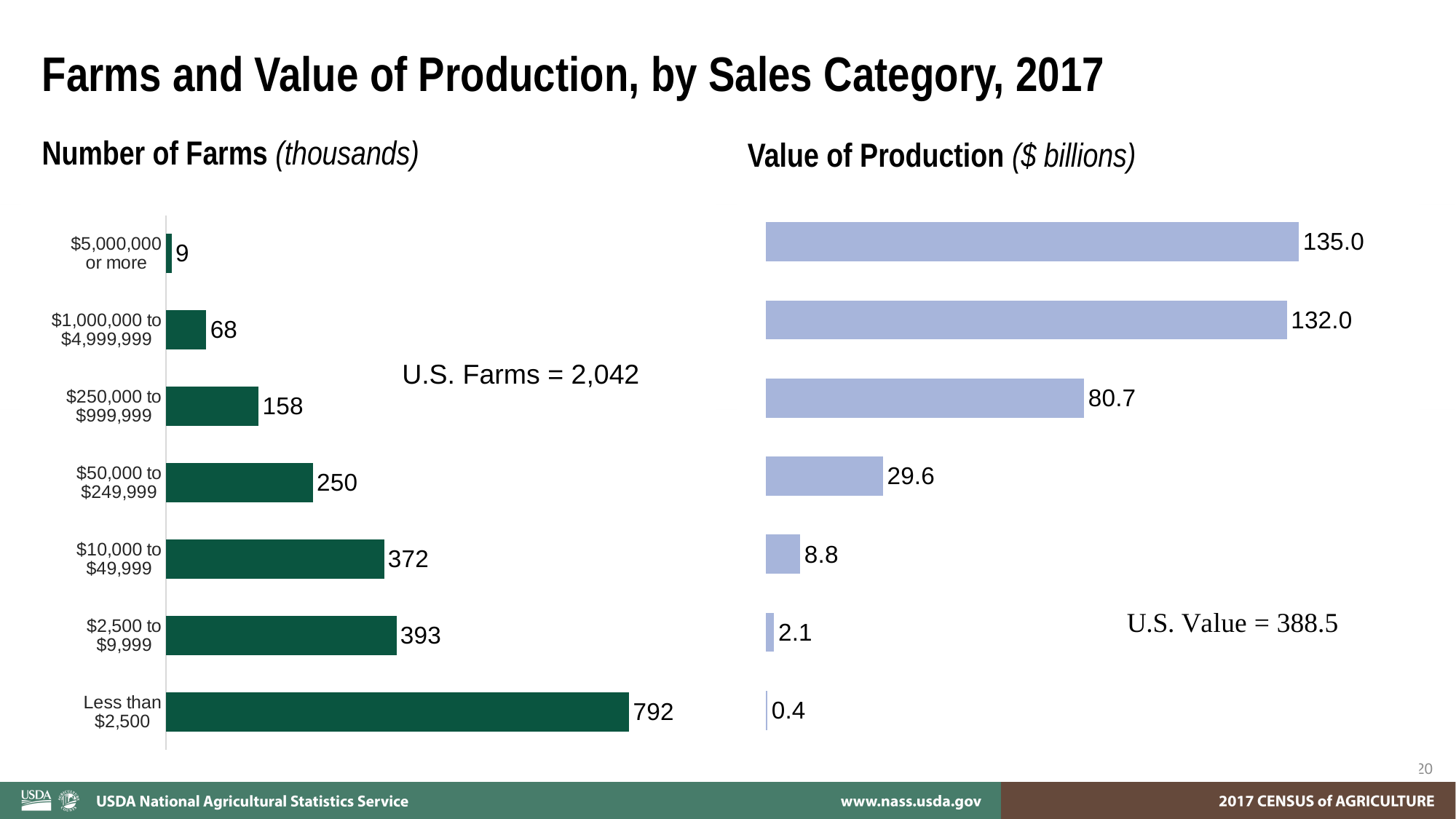
In the Value of Production chart, what is the value for the $250,000 to $999,999 category? 80.7 In the Value of Production chart, which sales category has the highest value of production? $5,000,000 or more In the Number of Farms chart, which sales category has the lowest number of farms? $5,000,000 or more How many sales categories are shown in the Number of Farms chart? 7 In the Value of Production chart, what is the value for the $2,500 to $9,999 category? 2.1 In the Value of Production chart, what is the difference between the $5,000,000 or more and $1,000,000 to $4,999,999 categories? 3.0 What kind of chart is the Value of Production chart? Bar chart In the Number of Farms chart, what is the value for the Less than $2,500 category? 792 In the Value of Production chart, which is larger: the value for $50,000 to $249,999 or $10,000 to $49,999? $50,000 to $249,999 In the Number of Farms chart, what is the total number of U.S. farms stated on the slide? 2,042 In the Number of Farms chart, which is larger: the value for $50,000 to $249,999 or $250,000 to $999,999? $50,000 to $249,999 In the Number of Farms chart, what is the difference between the $2,500 to $9,999 and $10,000 to $49,999 categories? 21